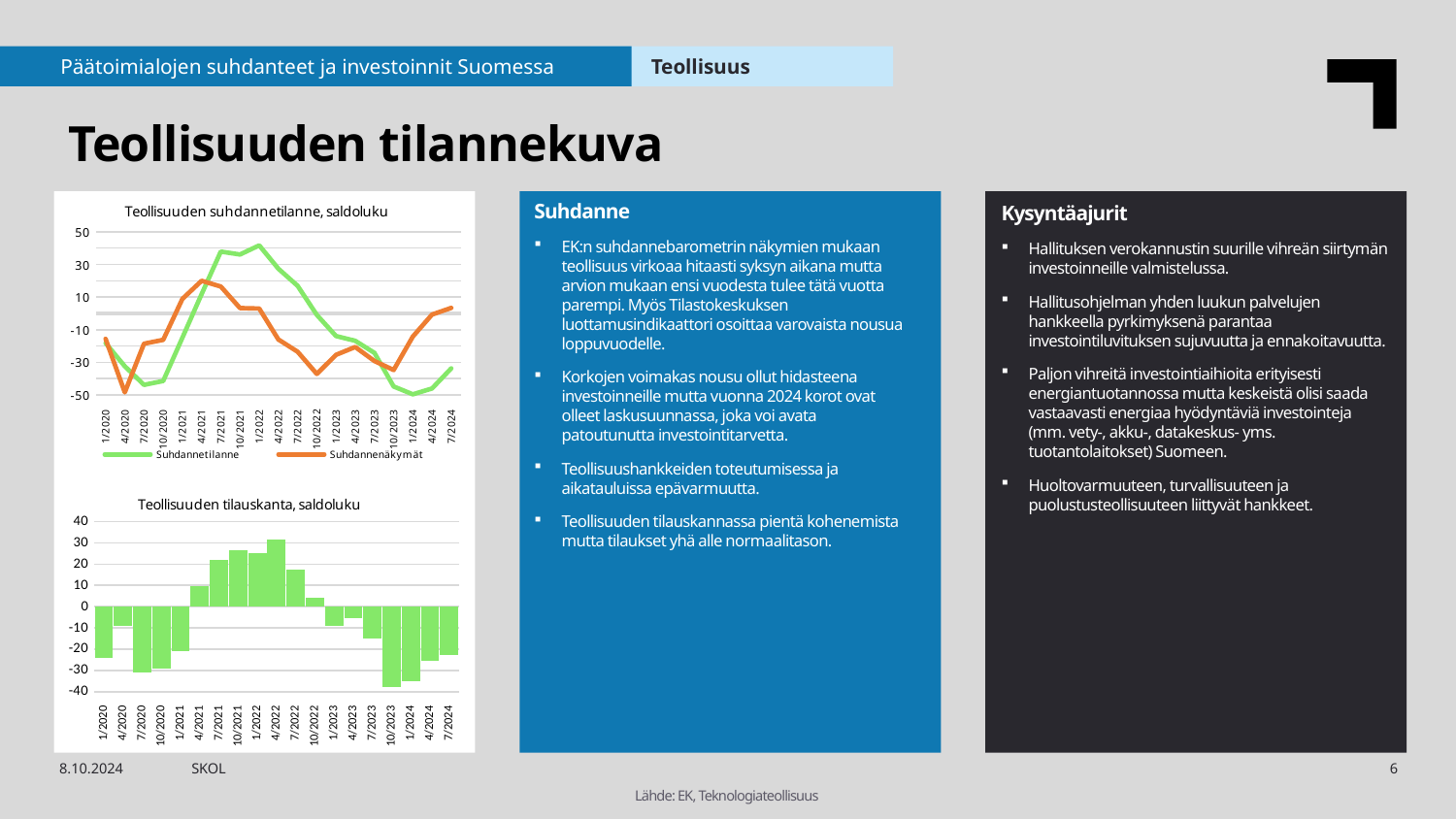
In the top chart 'Teollisuuden suhdannetilanne, saldoluku', is the Suhdannetilanne value for 1/2022 greater or less than 30? greater In the top chart 'Teollisuuden suhdannetilanne, saldoluku', how many series does the legend list? 2 In the bottom chart 'Teollisuuden tilauskanta, saldoluku', which is larger, the value for 4/2022 or the value for 7/2022? 4/2022 In the bottom chart 'Teollisuuden tilauskanta, saldoluku', do the values rise or fall from 4/2022 to 10/2023? fall What kind of chart is the bottom chart, 'Teollisuuden tilauskanta, saldoluku'? bar chart In the top chart 'Teollisuuden suhdannetilanne, saldoluku', what are the two legend entries? Suhdannetilanne and Suhdannenäkymät In the top chart 'Teollisuuden suhdannetilanne, saldoluku', is the Suhdannenäkymät value for 4/2020 greater or less than -30? less In the bottom chart 'Teollisuuden tilauskanta, saldoluku', is the value for 10/2023 greater or less than -30? less In the bottom chart 'Teollisuuden tilauskanta, saldoluku', how many bars are plotted? 19 What kind of chart is the top chart, 'Teollisuuden suhdannetilanne, saldoluku'? line chart In the bottom chart 'Teollisuuden tilauskanta, saldoluku', which date has the highest bar? 4/2022 In the top chart 'Teollisuuden suhdannetilanne, saldoluku', at which date does the Suhdannetilanne series reach its highest value? 1/2022